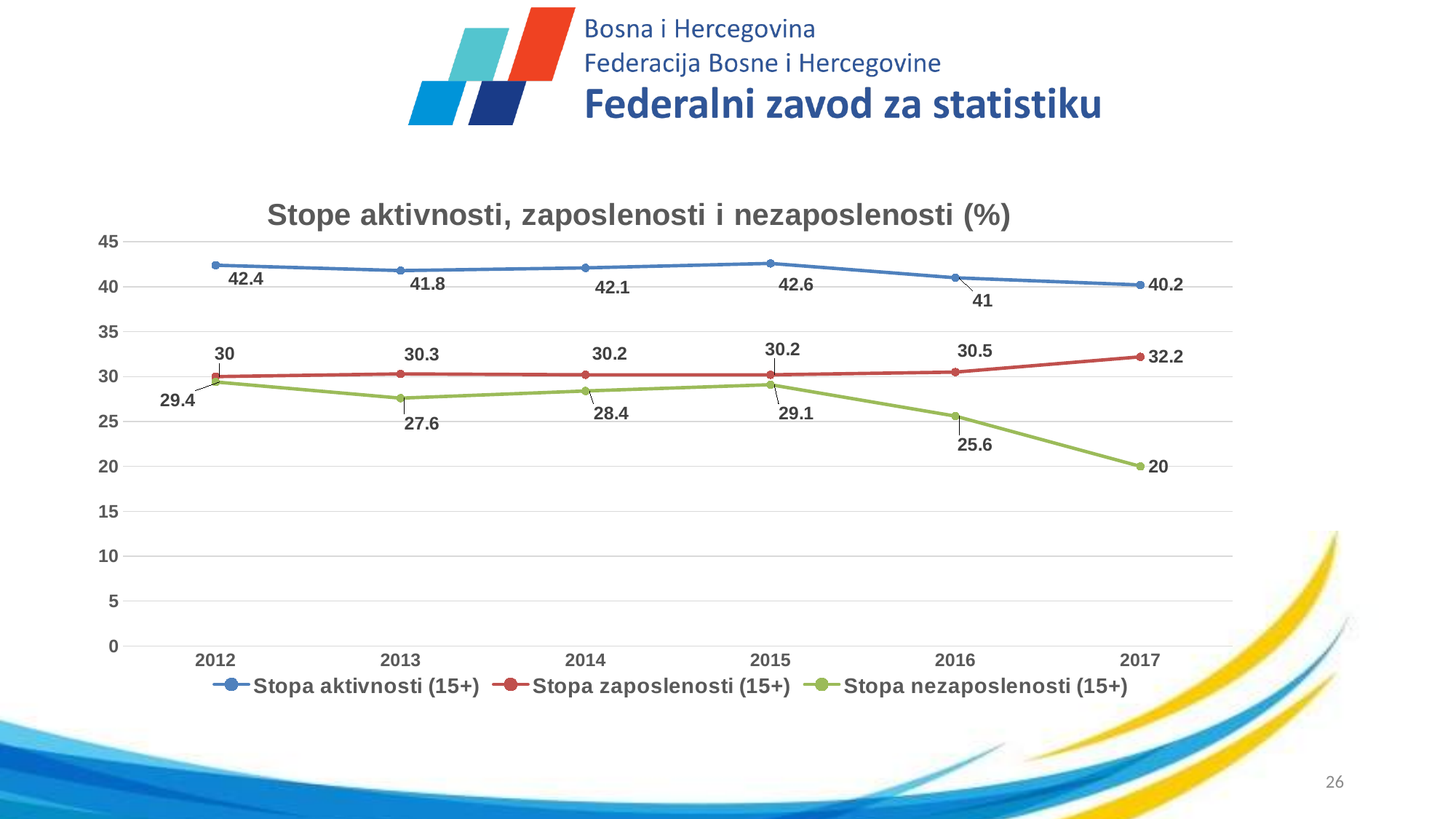
What is the difference between Stopa aktivnosti (15+) in 2012 and in 2017? 2.2 What is the value of Stopa aktivnosti (15+) in 2015? 42.6 Which is larger in 2016: Stopa zaposlenosti (15+) or Stopa nezaposlenosti (15+)? Stopa zaposlenosti (15+) What is the value of Stopa zaposlenosti (15+) in 2013? 30.3 Does Stopa nezaposlenosti (15+) rise or fall from 2015 to 2017? fall In which year is Stopa nezaposlenosti (15+) lowest? 2017 In which year is Stopa aktivnosti (15+) highest? 2015 What is the title of the chart? Stope aktivnosti, zaposlenosti i nezaposlenosti (%) How many years are shown on the x axis? 6 What kind of chart is this? line chart How many series does the legend list? 3 What is the value of Stopa nezaposlenosti (15+) in 2017? 20